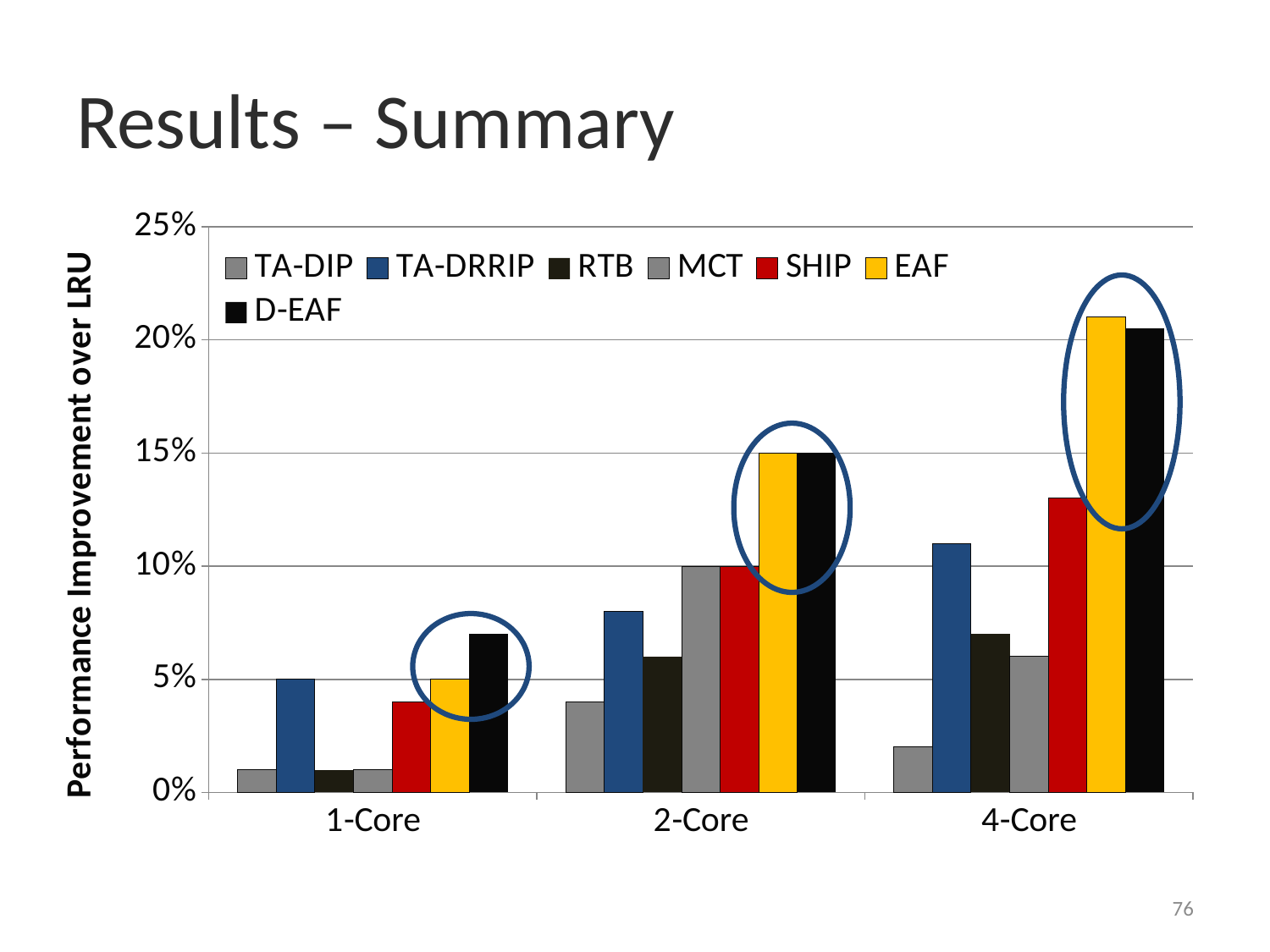
How many categories are shown on the x axis? 3 What is the value for TA-DRRIP in the 1-Core category? 5% How many series does the legend list? 7 Which is larger, the value for TA-DRRIP in 4-Core or the value for RTB in 4-Core? TA-DRRIP What is the value for EAF in the 2-Core category? 15% What is the value for SHIP in the 2-Core category? 10% Do the values for EAF rise or fall from 1-Core to 4-Core? rise What kind of chart is shown on the slide? bar chart Which series has the lowest value in the 4-Core category? TA-DIP Which series has the highest value in the 4-Core category? EAF Is the value for SHIP in the 4-Core category greater or less than 15%? less